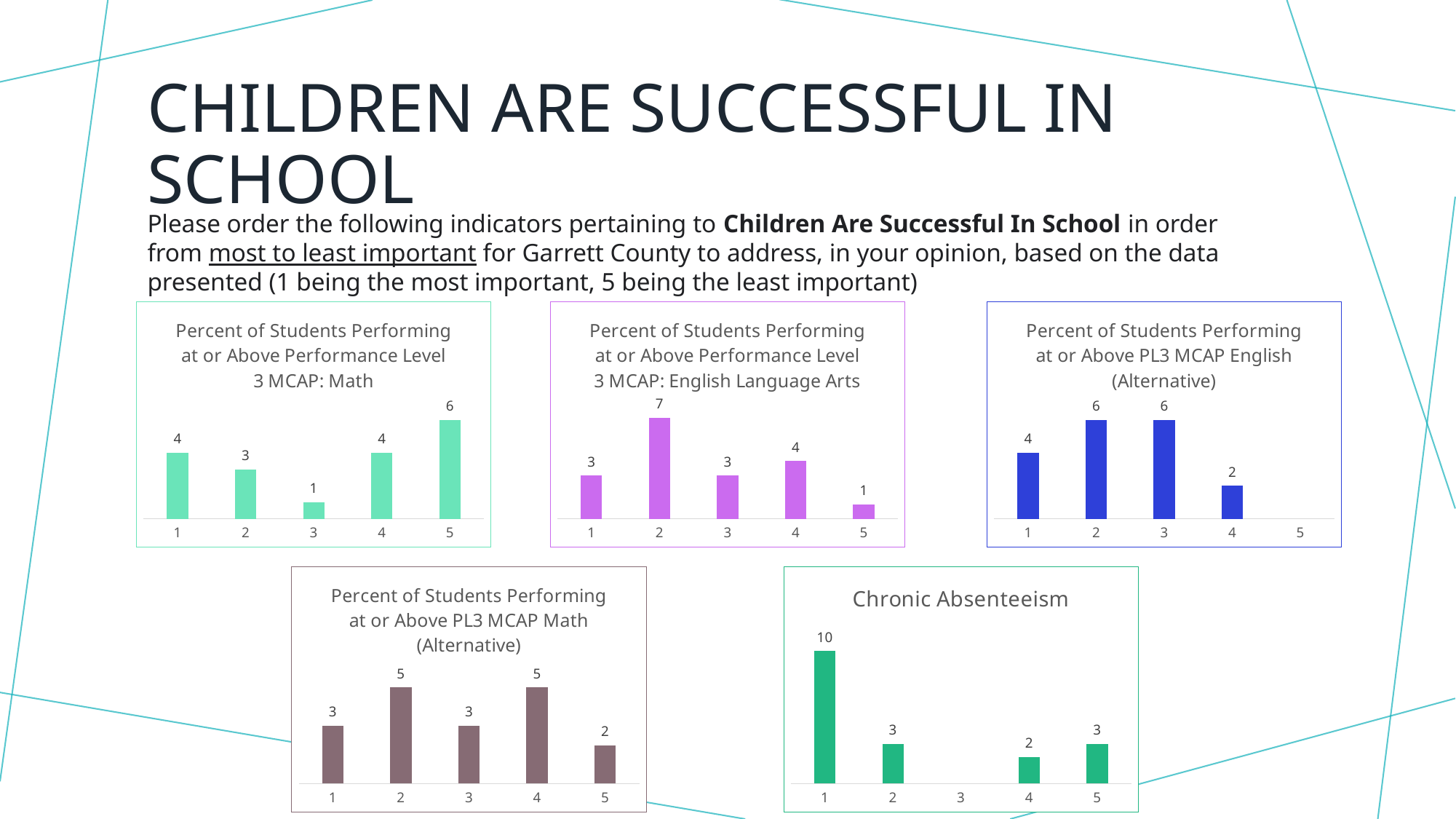
In the 'Percent of Students Performing at or Above Performance Level 3 MCAP: English Language Arts' chart, which category has the highest value? 2 In the 'Chronic Absenteeism' chart, what is the value for category 1? 10 In the 'Percent of Students Performing at or Above Performance Level 3 MCAP: English Language Arts' chart, what is the difference between the values for category 2 and category 5? 6 In the 'Chronic Absenteeism' chart, what is the difference between the values for category 1 and category 2? 7 In the 'Percent of Students Performing at or Above PL3 MCAP Math (Alternative)' chart, which is larger, the value for category 2 or category 5? Category 2 How many charts are shown on the slide? 5 In the 'Percent of Students Performing at or Above Performance Level 3 MCAP: Math' chart, what is the value for category 5? 6 In the 'Percent of Students Performing at or Above PL3 MCAP English (Alternative)' chart, which is larger, the value for category 1 or category 2? Category 2 What type of chart is the 'Chronic Absenteeism' chart? Bar chart In the 'Percent of Students Performing at or Above PL3 MCAP Math (Alternative)' chart, what is the value for category 3? 3 In the 'Percent of Students Performing at or Above PL3 MCAP English (Alternative)' chart, what is the value for category 4? 2 In the 'Percent of Students Performing at or Above Performance Level 3 MCAP: Math' chart, which category has the lowest value? 3